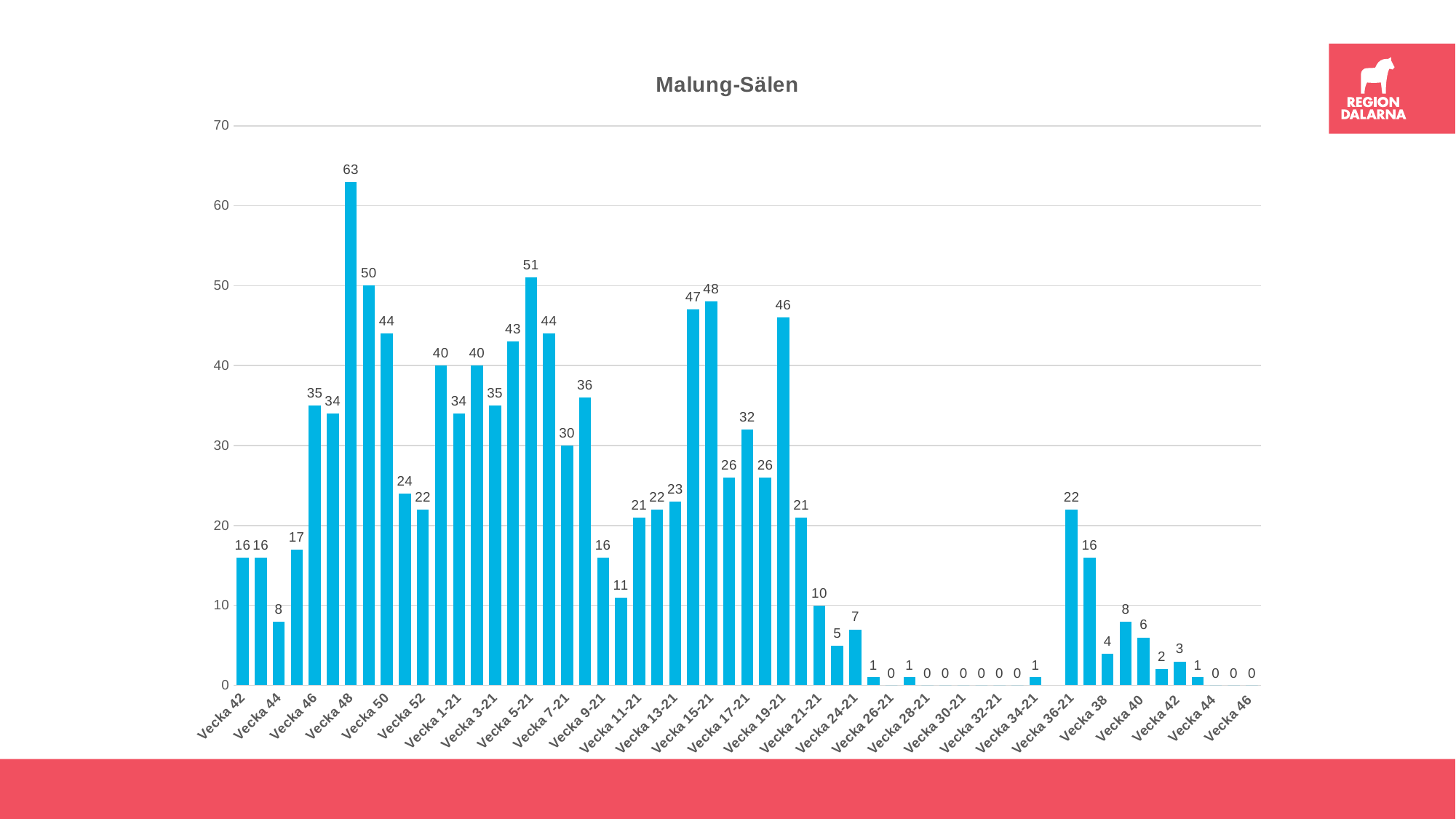
What is the highest value shown on the y axis? 70 What is the title of the chart? Malung-Sälen Overall, do the values rise or fall from the left of the x axis to the right? fall What is the difference between the highest value (63) and the second highest value (51)? 12 Which is larger, the value for Vecka 48 or the value for Vecka 36-21? Vecka 48 What is the value for Vecka 36-21? 22 What kind of chart is shown on the slide? bar chart What is the highest value shown in the chart? 63 What is the lowest value shown in the chart? 0 Is the value for Vecka 48 greater or less than 60? greater What is the value of the first bar (Vecka 42, at the left of the chart)? 16 Which week has the highest value in the chart? Vecka 48